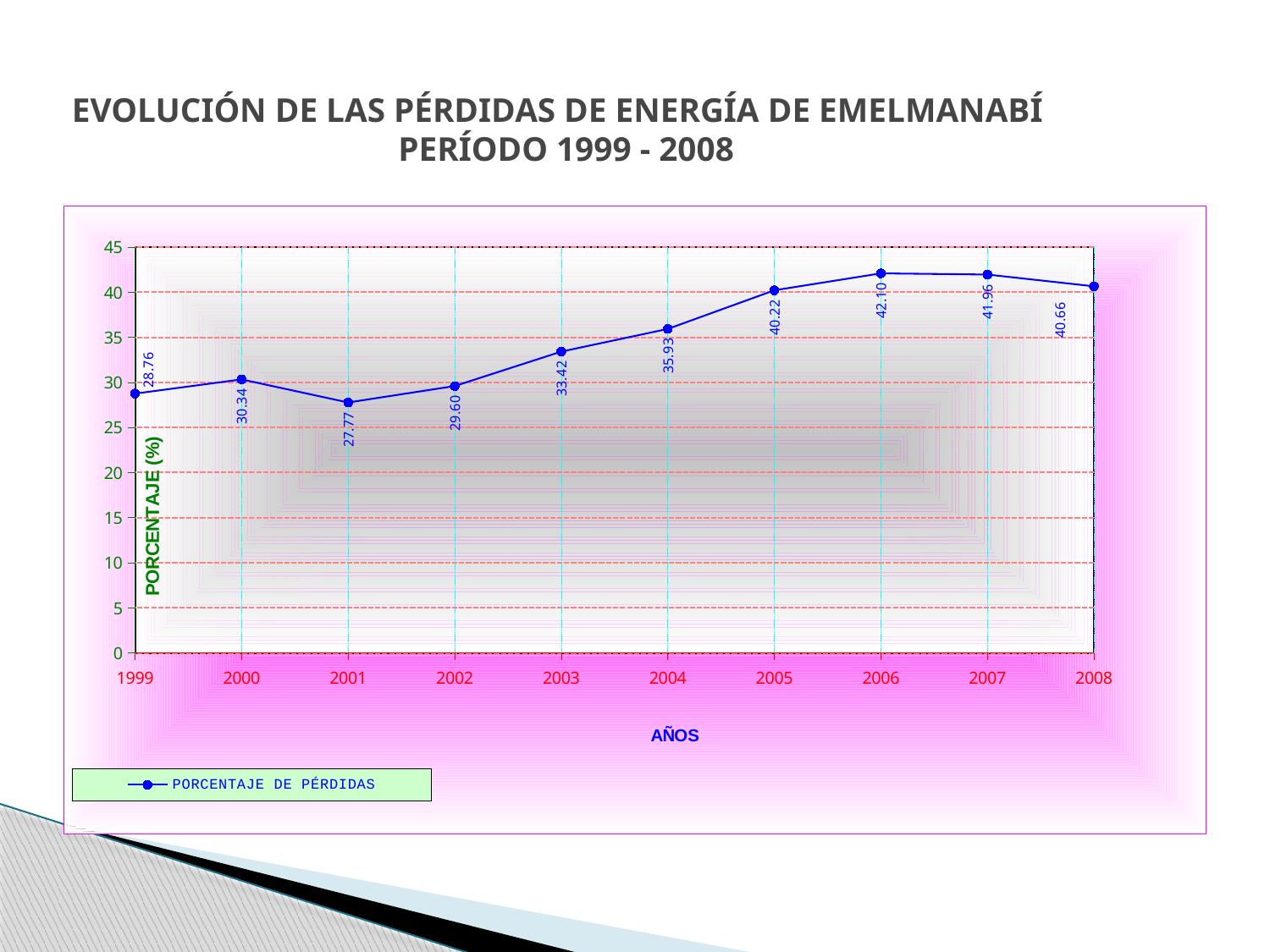
What kind of chart is shown on the slide? Line chart Which year has a higher percentage of losses, 2000 or 2002? 2000 What is the difference between the percentage of losses in 2008 and in 1999? 11.90 What is the percentage of losses for 2005? 40.22 Is the value for 2004 greater or less than 35? greater How many years are plotted on the chart? 10 Which year has the lowest percentage of losses? 2001 What is the label on the y axis of the chart? PORCENTAJE (%) What is the percentage of losses for 2008? 40.66 Which year has the highest percentage of losses? 2006 What is the percentage of losses (PORCENTAJE DE PÉRDIDAS) for 1999? 28.76 What is the difference between the percentage of losses in 2006 and in 2005? 1.88